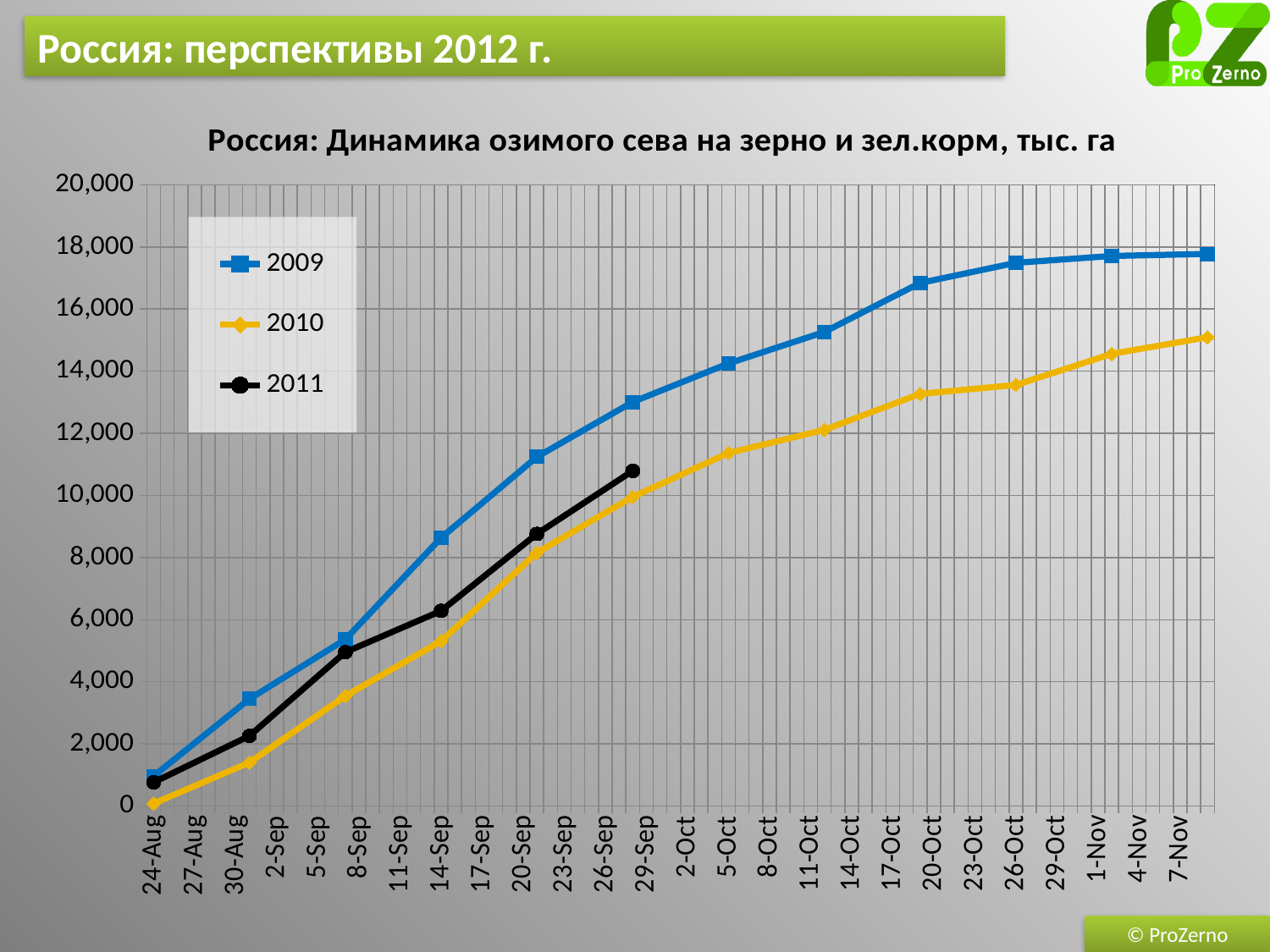
Is the value for 2010 at 7-Nov greater or less than 16,000? less Is the value for 2010 at 24-Aug greater or less than 2,000? less What colour is the line for the 2011 series? black Is the last plotted value for 2011 greater or less than 12,000? less Which series has the highest value at 7-Nov? 2009 What kind of chart is shown on the slide? line chart Do the values for the 2009 series rise or fall along the x axis? rise Which series has the lowest value at 24-Aug? 2010 Which years are listed in the legend? 2009, 2010, 2011 At 14-Sep, which series has the larger value, 2009 or 2011? 2009 How many series does the legend list? 3